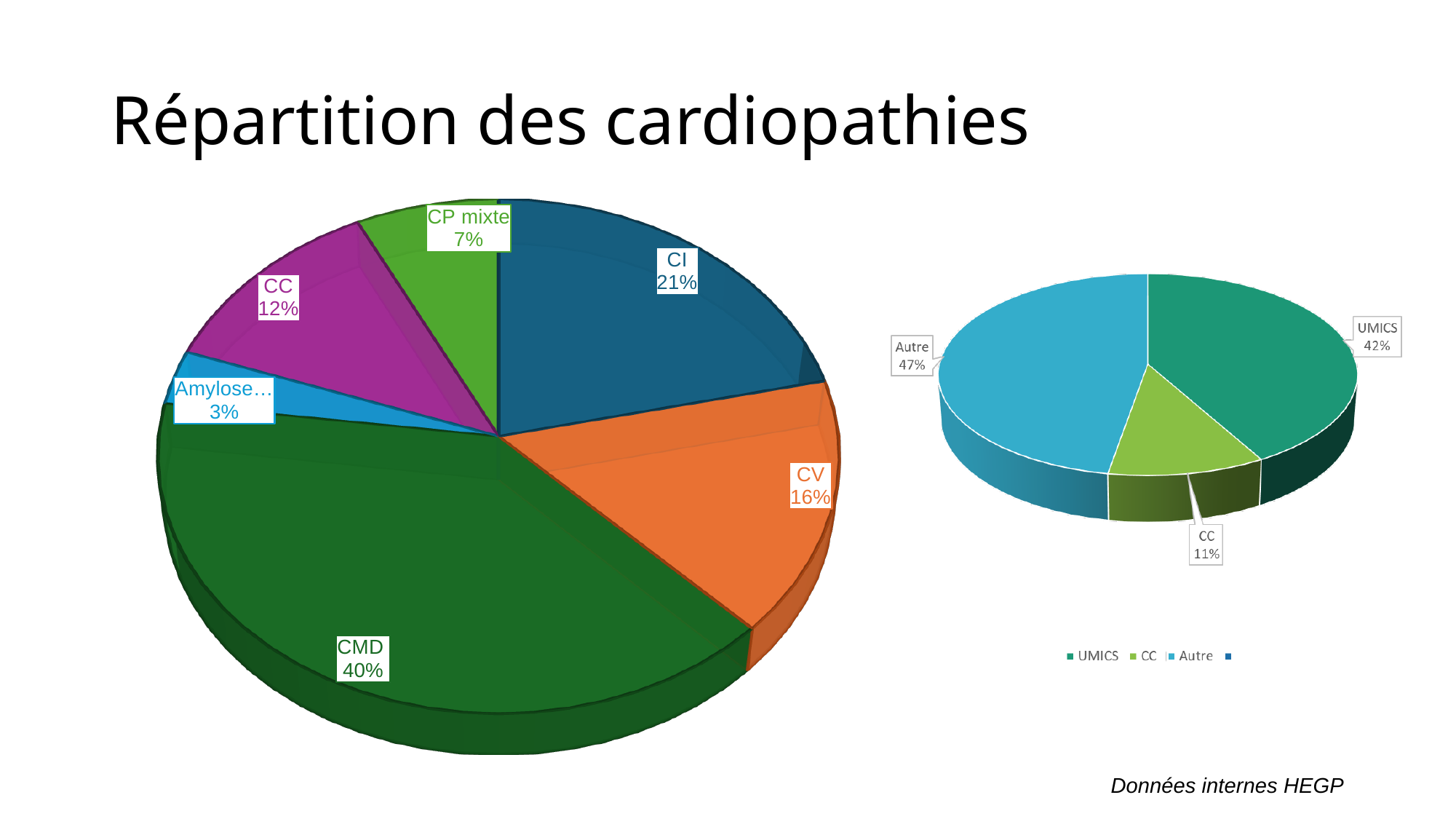
In the right pie chart, which category has the largest share? Autre In the left pie chart, what share does CMD have? 40% What is the title of the slide containing the two pie charts? Répartition des cardiopathies In the left pie chart, what share does CI have? 21% In the right pie chart, what share does UMICS have? 42% In the right pie chart, what is the difference between the shares of Autre and CC? 36% How many slices does the left pie chart have? 6 In the left pie chart, which is larger, CC or CP mixte? CC In the left pie chart, what is the difference between the shares of CI and CV? 5% What kind of chart is the left chart? Pie chart In the left pie chart, which category has the largest share? CMD In the left pie chart, which category has the smallest share? Amylose…